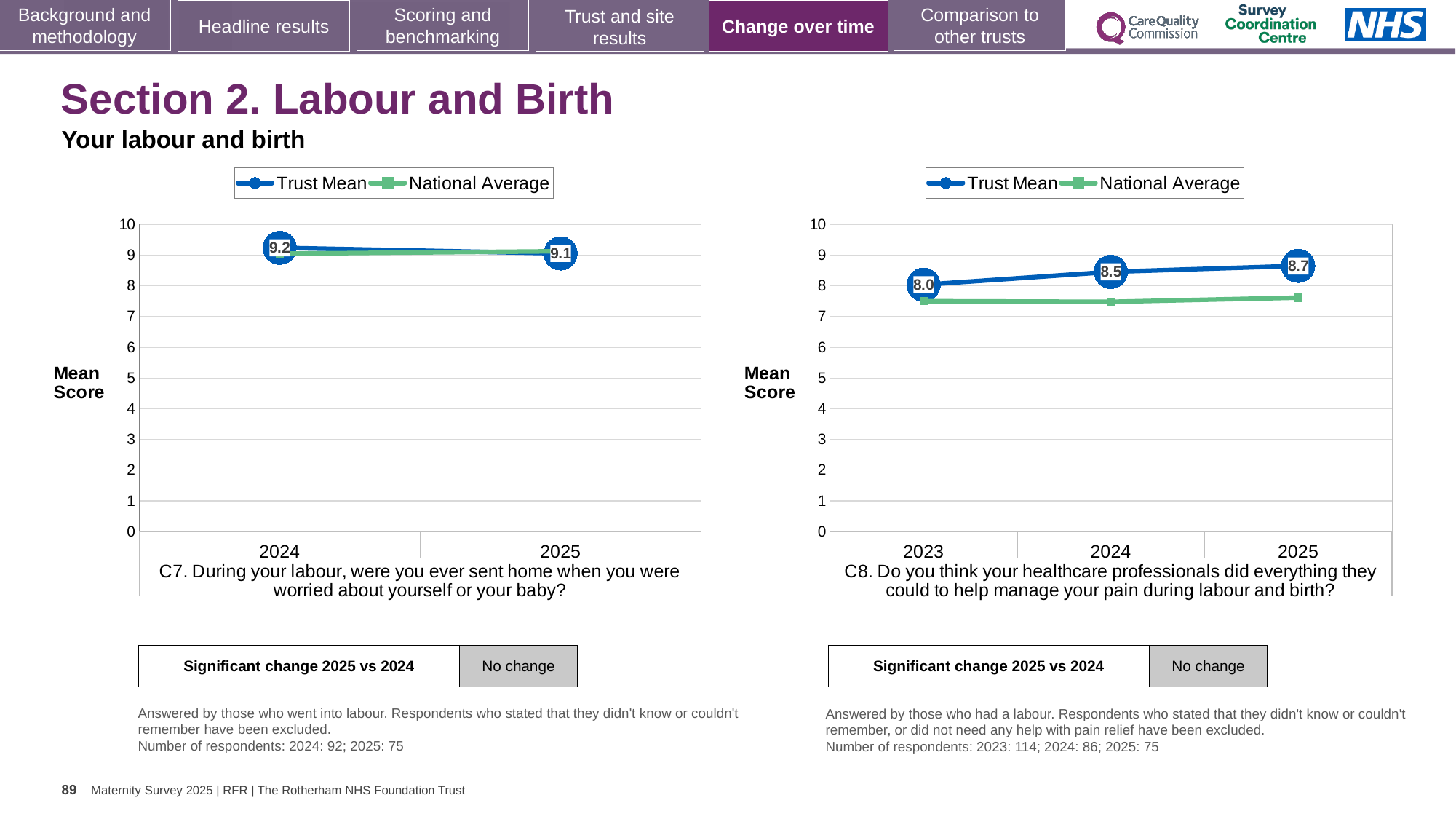
How many series does the legend of the C7 chart on the left list? 2 How many years are shown on the x axis of the C8 chart on the right? 3 In the C8 chart on the right, which is larger in 2025, the Trust Mean or the National Average? Trust Mean In the C7 chart on the left, what is the Trust Mean for 2025? 9.1 In the C8 chart on the right, what is the difference between the Trust Mean for 2025 and 2023? 0.7 In the C8 chart on the right, what is the Trust Mean for 2025? 8.7 In the C8 chart on the right, does the Trust Mean rise or fall from 2023 to 2025? rise In the C8 chart on the right, which year has the highest Trust Mean? 2025 In the C8 chart on the right, is the National Average for 2024 greater or less than 8? less In the C7 chart on the left, what is the Trust Mean for 2024? 9.2 In the C8 chart on the right, what is the Trust Mean for 2023? 8.0 In the C8 chart on the right, which year has the lowest Trust Mean? 2023